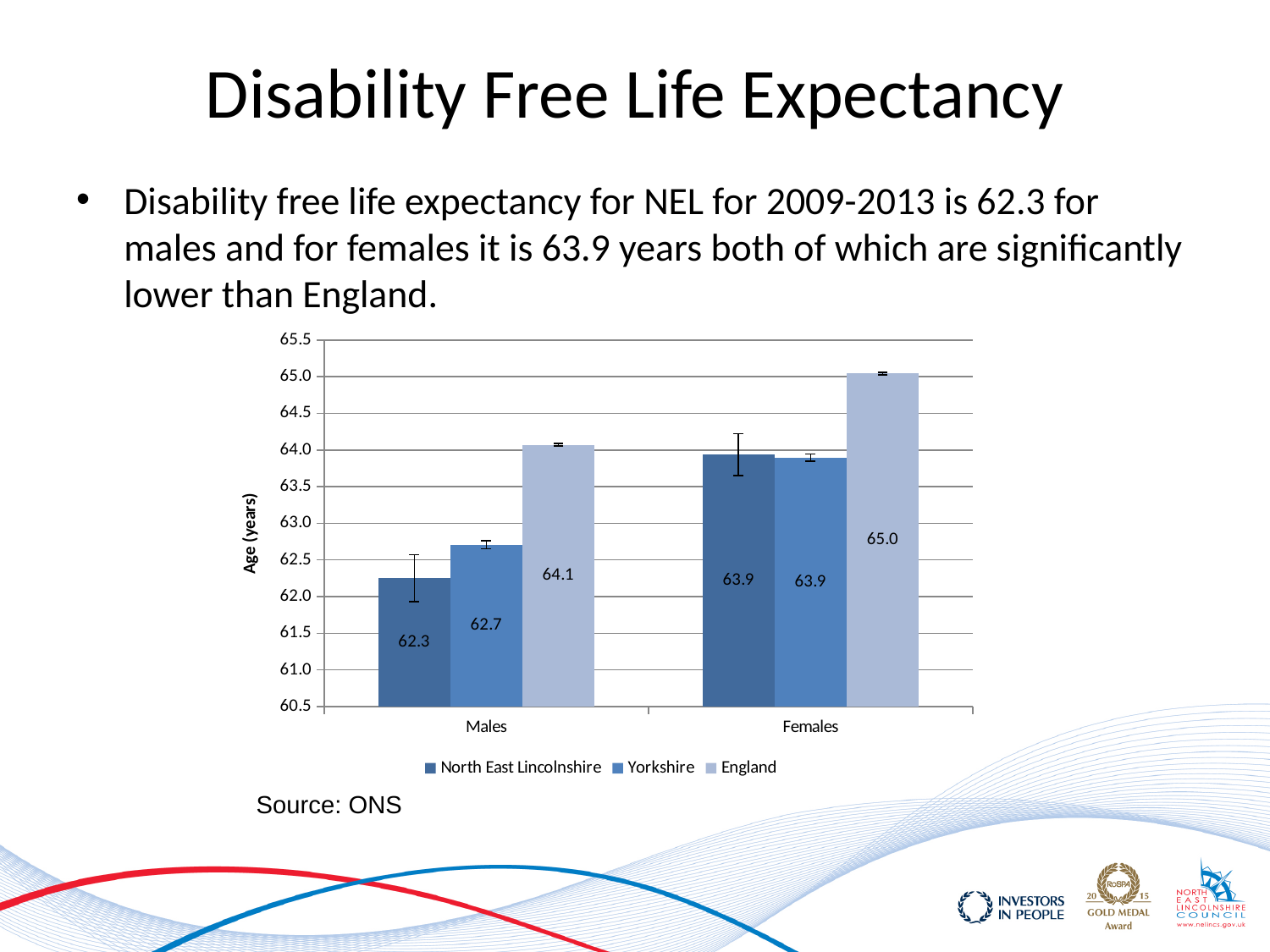
What kind of chart is shown on the slide? Bar chart What is the value for England in the Females category? 65.0 What is the difference between the England and North East Lincolnshire values for Males? 1.8 How many series does the legend list? 3 Which series has the highest value in the Males category? England Is the value for England in the Females category greater or less than 64.5? greater What is the disability free life expectancy for North East Lincolnshire males? 62.3 What is the value for Yorkshire in the Males category? 62.7 What is the difference between the England values for Females and Males? 0.9 What is the label of the vertical axis? Age (years) Which series has the lowest value in the Males category? North East Lincolnshire Which is larger: the Yorkshire value for Males or the Yorkshire value for Females? Females